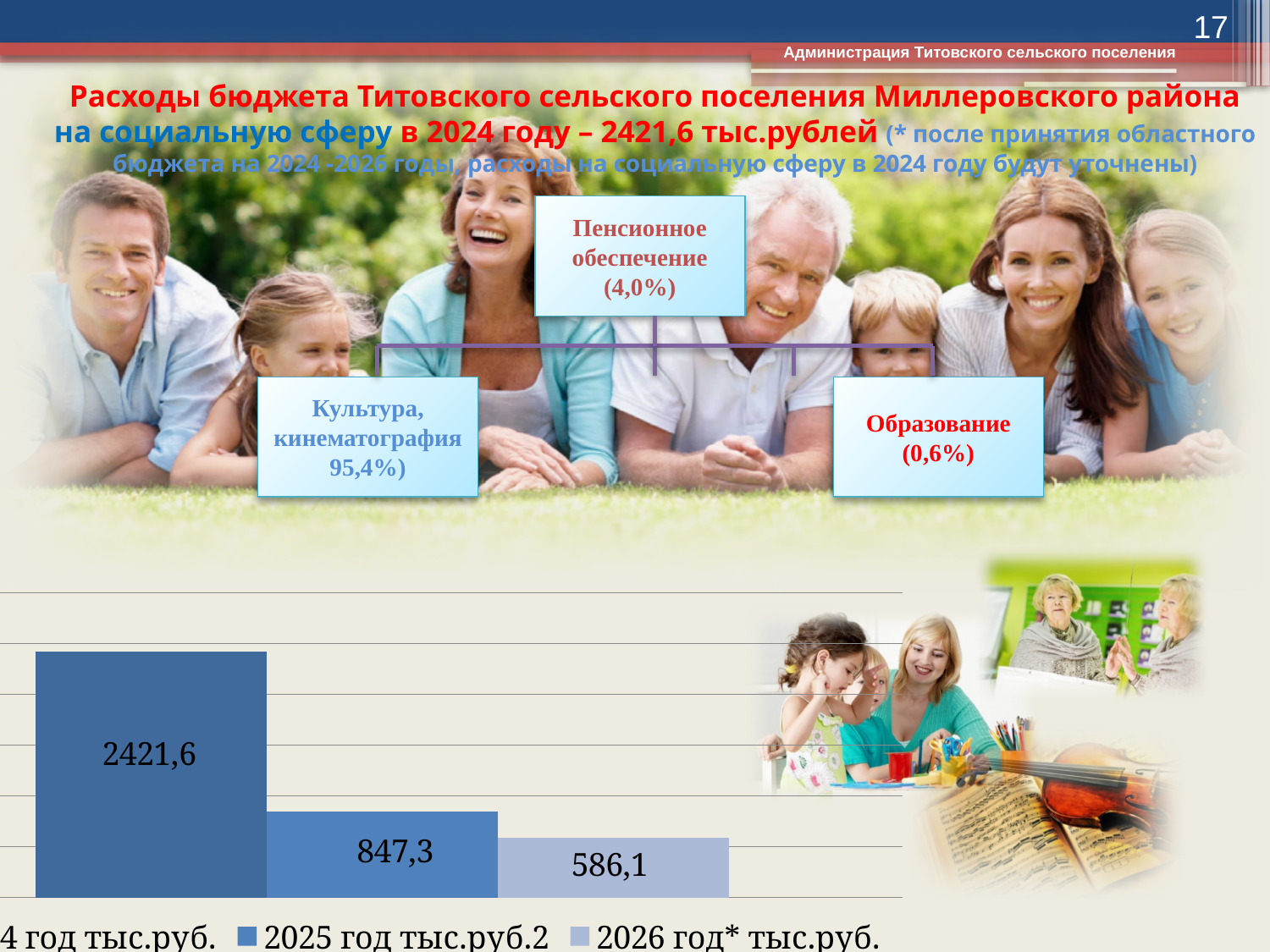
What is the value of the bar for 2026 год* тыс.руб. in the bar chart? 586,1 How many bars are plotted in the bar chart? 3 What is the difference between the 2025 год bar (847,3) and the 2026 год* bar (586,1)? 261,2 What colour is the bar for 2026 год* тыс.руб. in the bar chart? light blue How many series does the legend of the bar chart list? 3 What is the value of the tallest (leftmost, dark blue) bar in the bar chart? 2421,6 What is the difference between the leftmost bar (2421,6) and the 2025 год bar (847,3)? 1574,3 Do the bar values rise or fall from left to right in the bar chart? fall What type of chart is shown at the bottom of the slide? bar chart What is the value of the bar for 2025 год тыс.руб. in the bar chart? 847,3 Which legend series has the lowest value in the bar chart? 2026 год* тыс.руб. Which is larger in the bar chart: the value for 2025 год or the value for 2026 год*? 2025 год